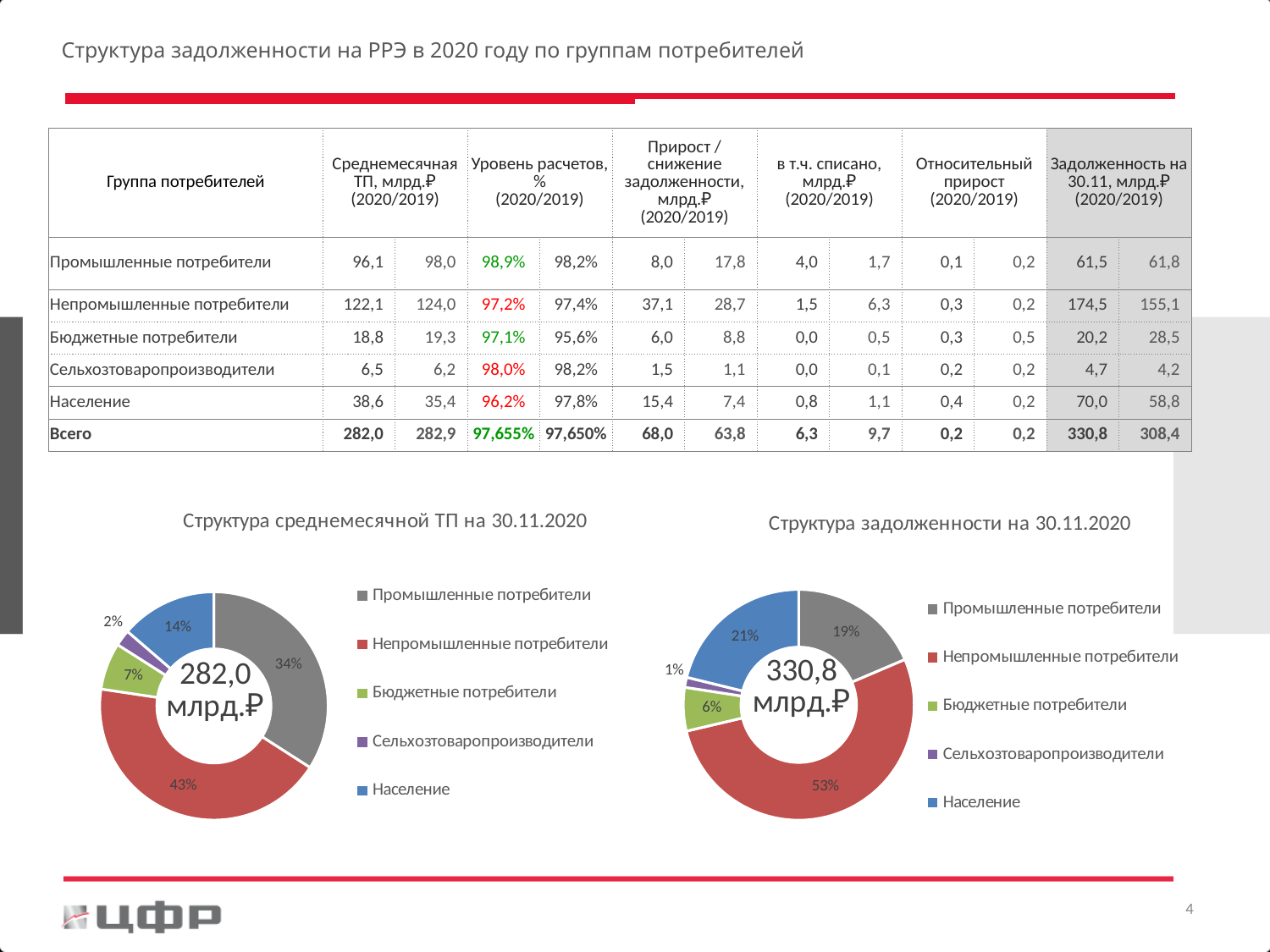
In the chart titled "Структура среднемесячной ТП на 30.11.2020", what share does "Непромышленные потребители" have? 43% In the chart titled "Структура среднемесячной ТП на 30.11.2020", what is the difference in percentage points between "Непромышленные потребители" and "Промышленные потребители"? 9 percentage points In the chart titled "Структура задолженности на 30.11.2020", what share does "Бюджетные потребители" have? 6% In the chart titled "Структура среднемесячной ТП на 30.11.2020", what share does "Население" have? 14% In the chart titled "Структура среднемесячной ТП на 30.11.2020", which category has the smallest share? Сельхозтоваропроизводители In the chart titled "Структура задолженности на 30.11.2020", which is larger: the share of "Население" or the share of "Промышленные потребители"? Население What type of chart is "Структура среднемесячной ТП на 30.11.2020"? Doughnut (pie) chart In the chart titled "Структура задолженности на 30.11.2020", which category has the smallest share? Сельхозтоваропроизводители In the chart titled "Структура среднемесячной ТП на 30.11.2020", which category has the largest share? Непромышленные потребители What total value is shown in the centre of the chart titled "Структура задолженности на 30.11.2020"? 330,8 млрд.₽ How many categories does the legend of the chart titled "Структура задолженности на 30.11.2020" list? 5